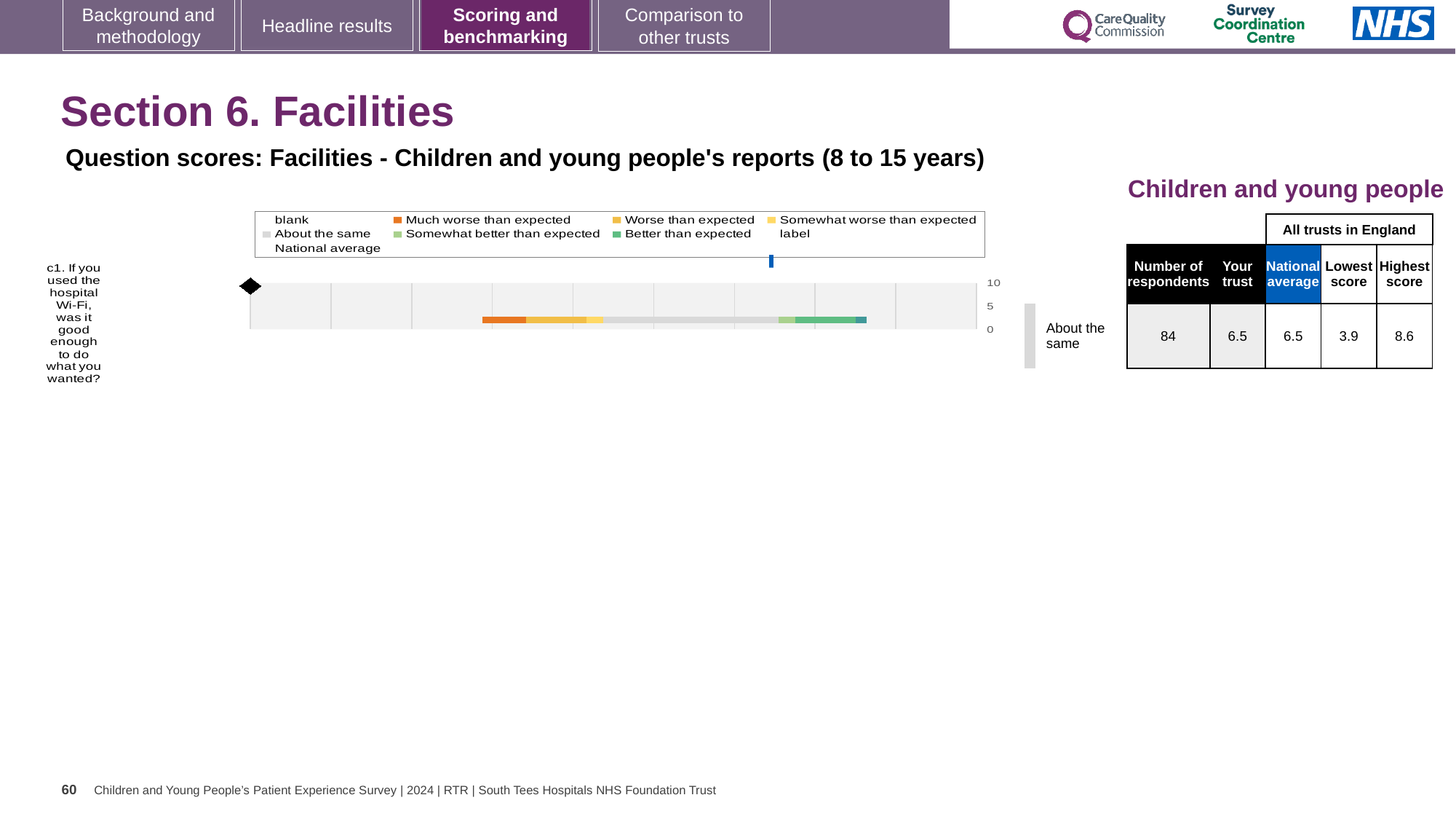
What is the difference between the highest and lowest scores for question c1 across all trusts in England? 4.7 What is the national average score for question c1? 6.5 How many respondents answered question c1? 84 What benchmark category is the trust's result for question c1 placed in? About the same Which is larger for question c1: the trust's score or the lowest score in England? the trust's score Which question is plotted in the chart? c1. If you used the hospital Wi-Fi, was it good enough to do what you wanted? What kind of chart is shown on the slide? bar chart What is the lowest score among all trusts in England for question c1? 3.9 What is the trust's score for question c1 according to the table next to the chart? 6.5 What is the highest value shown on the chart's axis? 10 How many questions (categories) are plotted in the chart? 1 What is the highest score among all trusts in England for question c1? 8.6